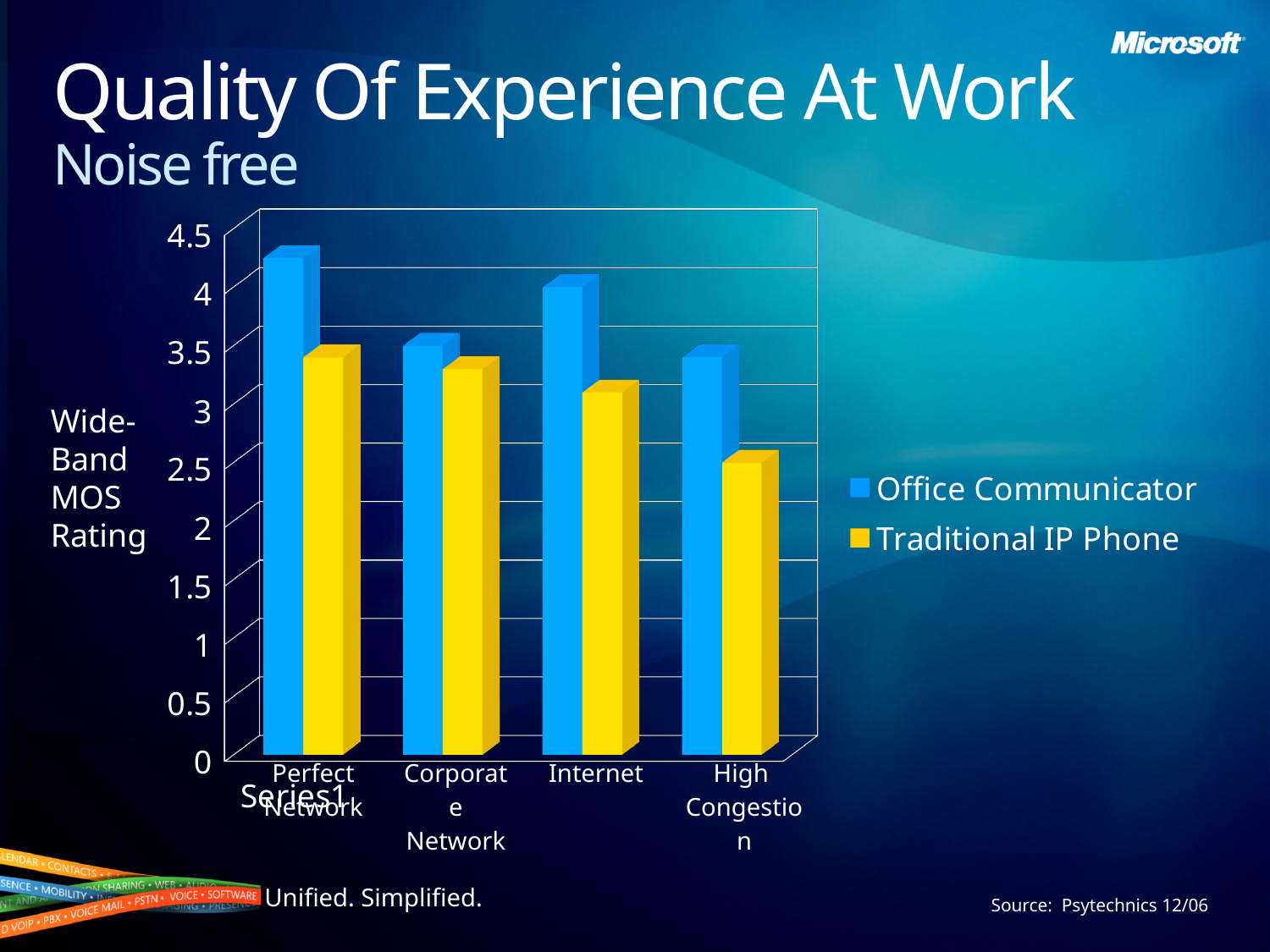
Is the Traditional IP Phone value for High Congestion greater or less than 3? less Under High Congestion, which is larger: Office Communicator or Traditional IP Phone? Office Communicator Is the Traditional IP Phone value for Perfect Network greater or less than 4? less What is the label on the vertical axis of the chart? Wide-Band MOS Rating Which series does the yellow bar represent? Traditional IP Phone For which network category is the Traditional IP Phone value lowest? High Congestion How many network categories are shown on the x axis? 4 Is the Office Communicator value for Perfect Network greater or less than 4? greater Do the Traditional IP Phone values rise or fall from Perfect Network to High Congestion? fall How many series does the legend list? 2 For which network category is the Office Communicator value highest? Perfect Network What kind of chart is shown on the slide? bar chart